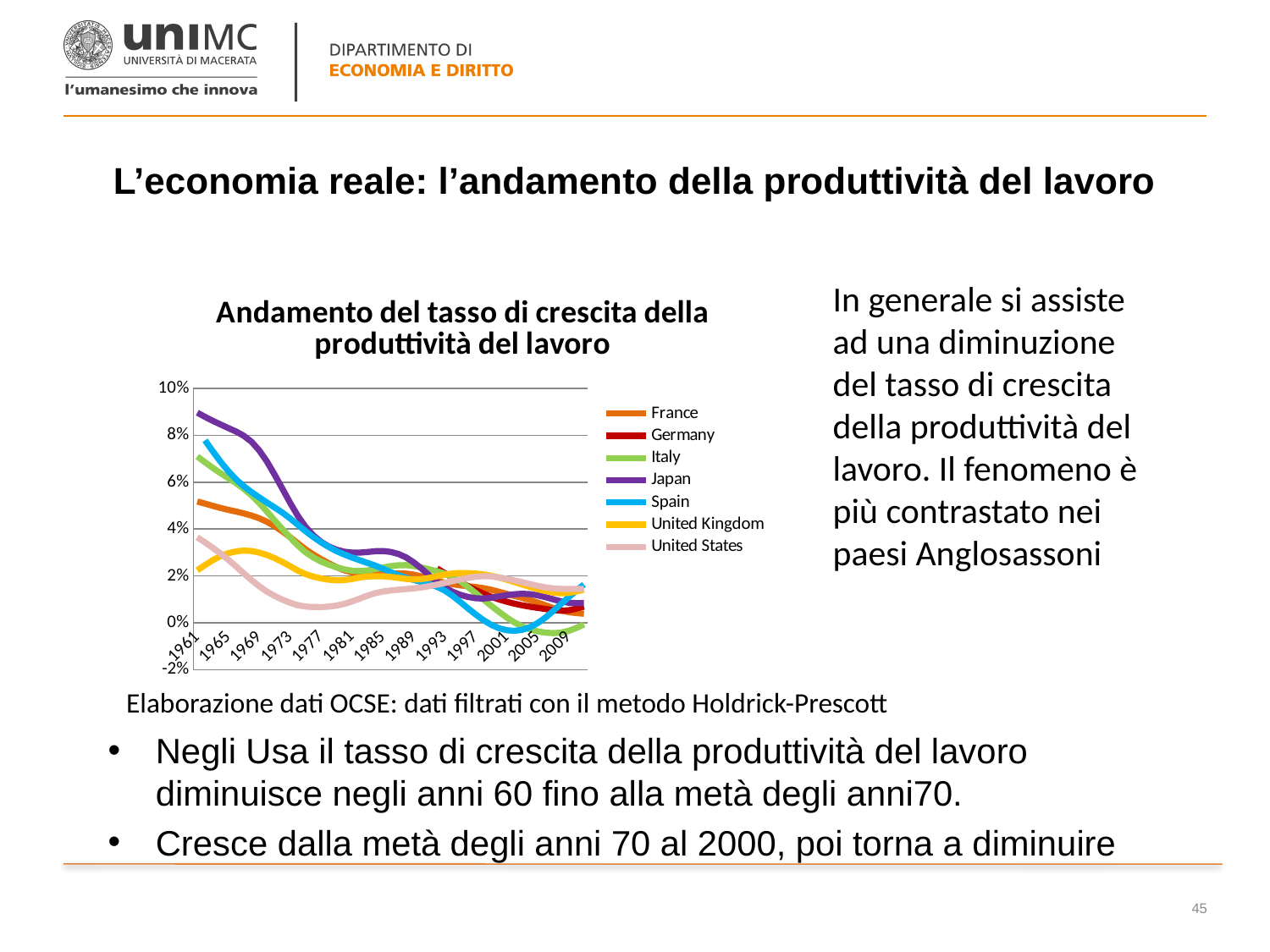
Is the value for the United Kingdom in 1961 greater or less than 4%? less Which country has the lowest productivity growth rate in 1961? United Kingdom Which country has the highest productivity growth rate in 1961? Japan How many series does the legend of the chart list? 7 What is the title of the chart? Andamento del tasso di crescita della produttività del lavoro Is the value for the United States in 1977 greater or less than 2%? less What is the highest value shown on the vertical axis of the chart? 10% What kind of chart is shown on the slide? line chart Does the line for Japan generally rise or fall from 1961 to 2009? fall Is the value for France in 1961 greater or less than 4%? greater In 1961, which is larger: the value for Japan or the value for France? Japan